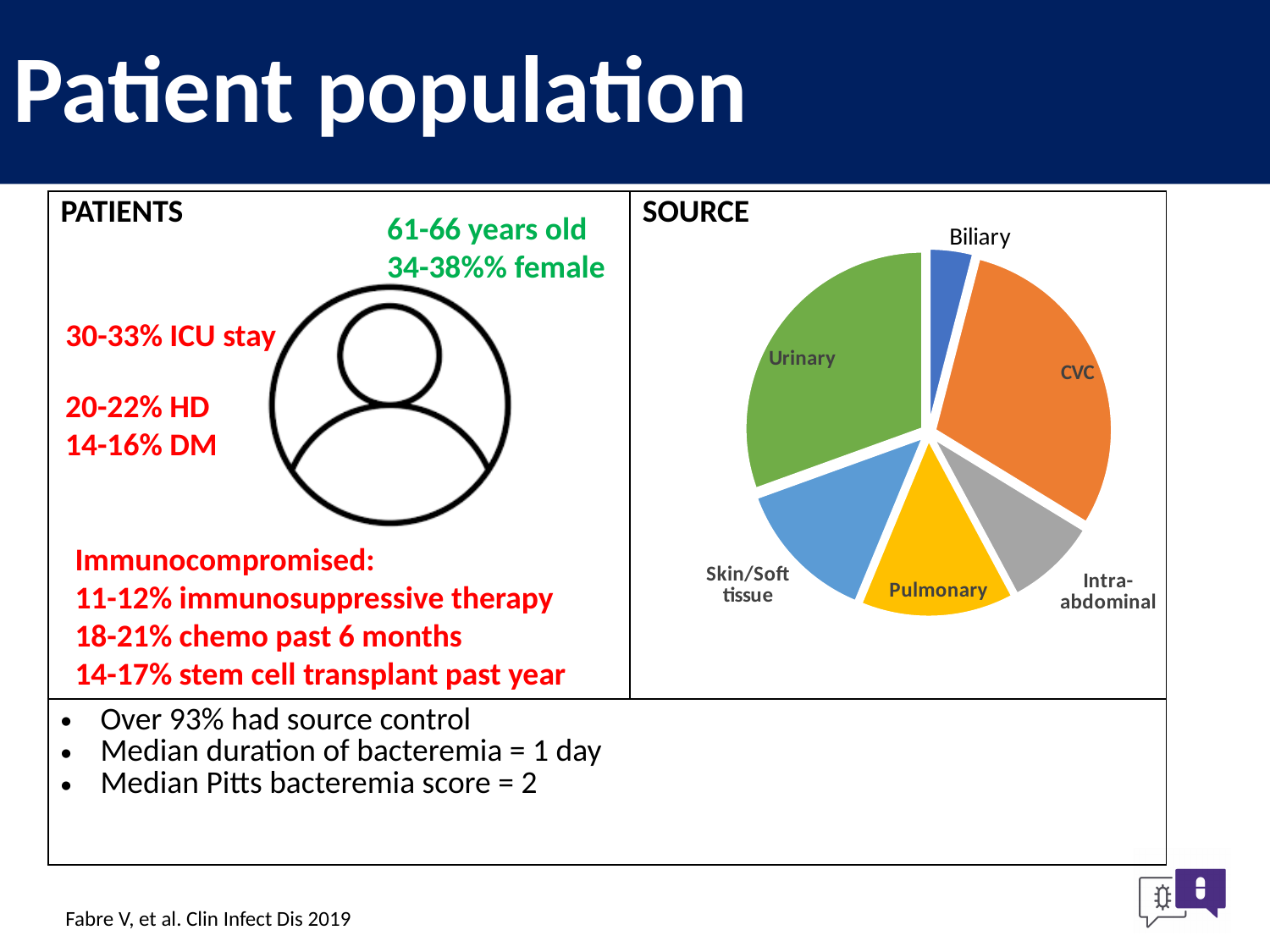
In the pie chart, which slice is larger: Intra-abdominal or Urinary? Urinary Which source category has the smallest slice in the pie chart? Biliary What colour is the CVC slice in the pie chart? orange In the pie chart, which slice is larger: Intra-abdominal or CVC? CVC What kind of chart is shown under the SOURCE heading? pie chart In the pie chart, which slice is larger: Biliary or Skin/Soft tissue? Skin/Soft tissue How many source categories are shown in the pie chart? 6 What is the heading above the pie chart? SOURCE